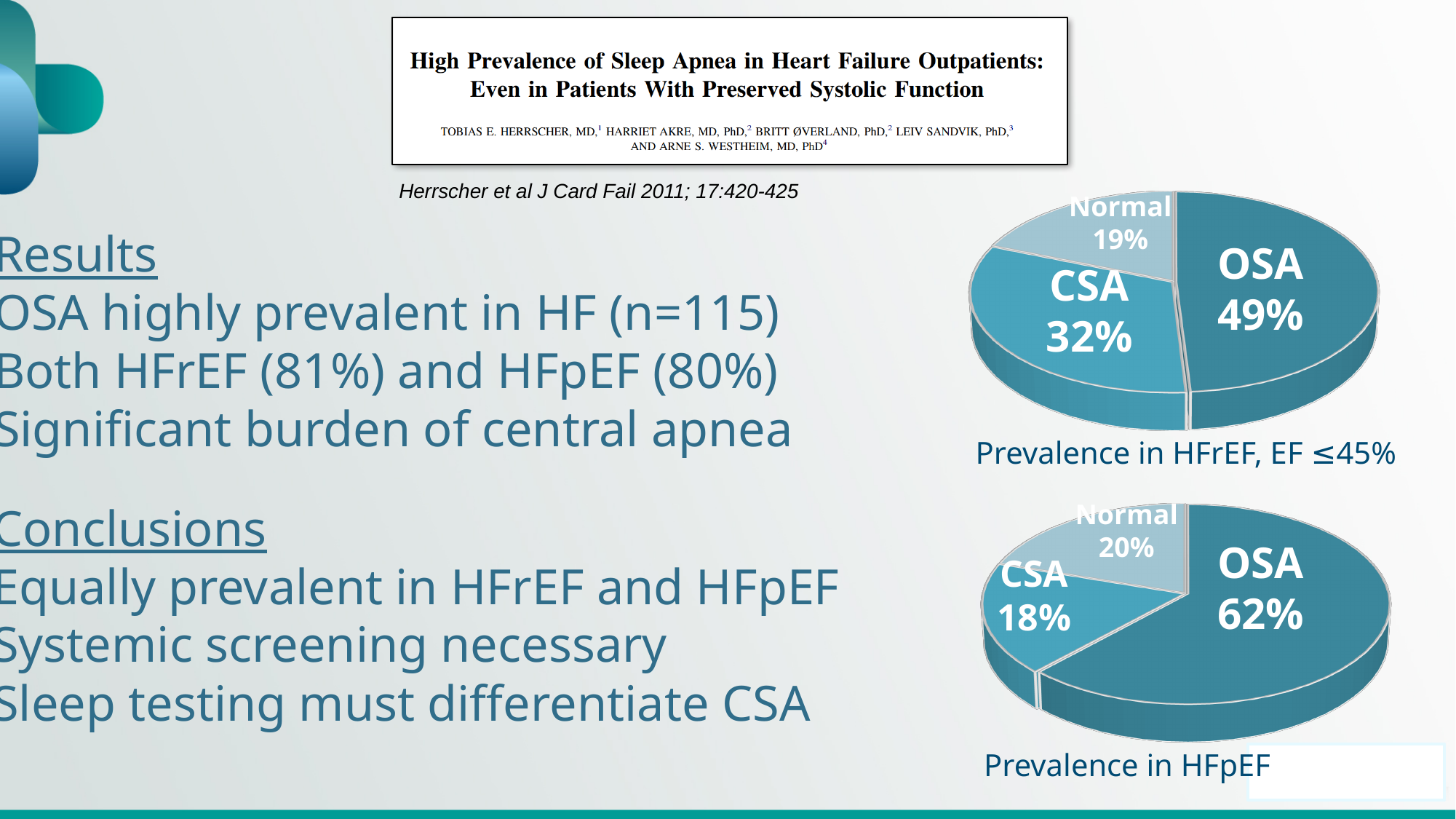
What type of chart is used for 'Prevalence in HFrEF, EF ≤45%'? Pie chart In the 'Prevalence in HFrEF, EF ≤45%' pie chart, which slice is the largest? OSA How many slices does the 'Prevalence in HFpEF' pie chart have? 3 In the 'Prevalence in HFpEF' pie chart, which slice is the smallest? CSA In the 'Prevalence in HFpEF' pie chart, what share is labelled for CSA? 18% In the 'Prevalence in HFrEF, EF ≤45%' pie chart, what share is labelled for OSA? 49% In the 'Prevalence in HFrEF, EF ≤45%' pie chart, what share is labelled for Normal? 19% In the 'Prevalence in HFrEF, EF ≤45%' pie chart, what is the difference between the OSA and CSA shares? 17% In the 'Prevalence in HFrEF, EF ≤45%' pie chart, what share is labelled for CSA? 32% In the 'Prevalence in HFpEF' pie chart, what share is labelled for Normal? 20% In the 'Prevalence in HFpEF' pie chart, what share is labelled for OSA? 62% Which chart shows a larger OSA share, 'Prevalence in HFrEF, EF ≤45%' or 'Prevalence in HFpEF'? Prevalence in HFpEF